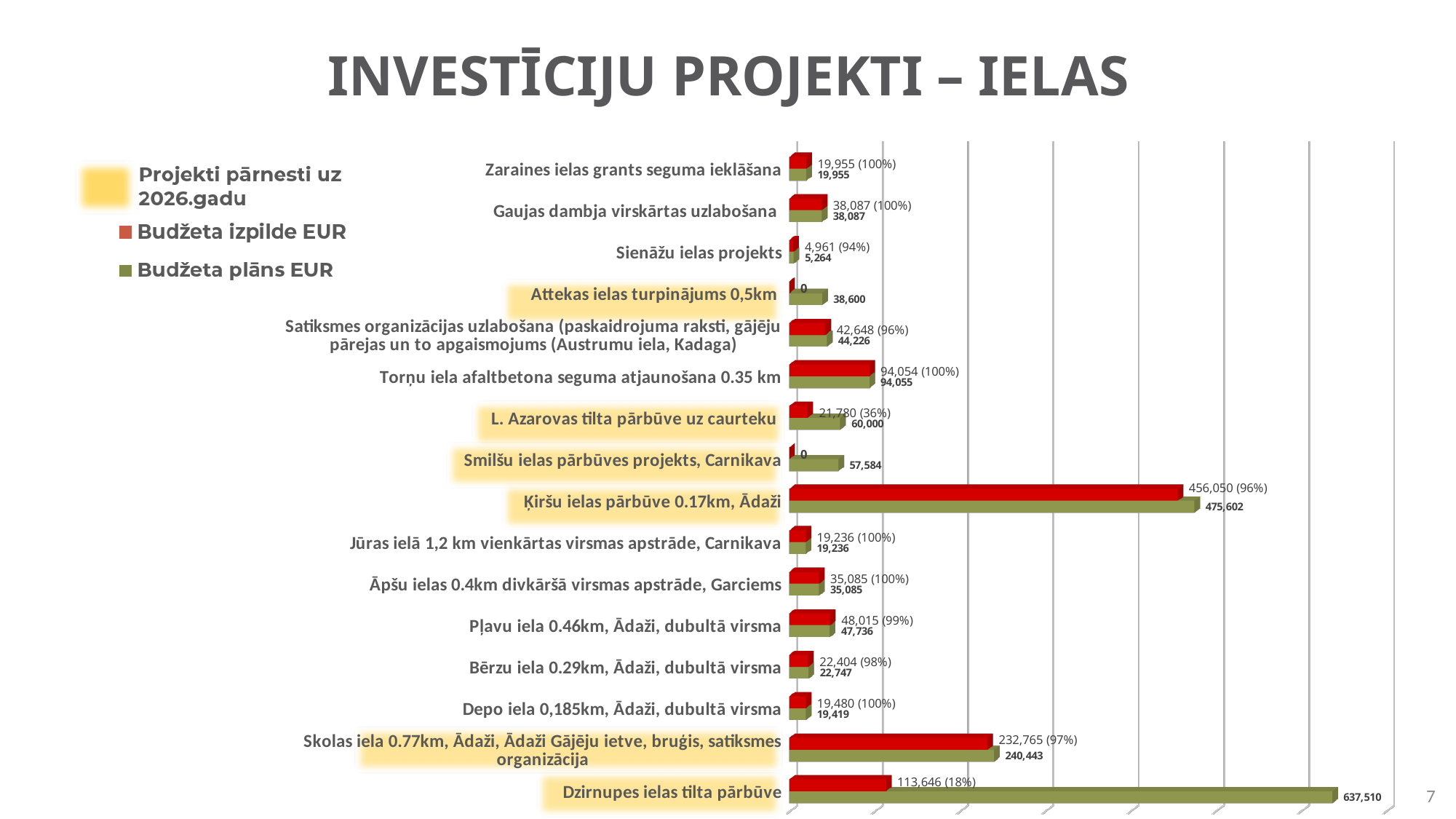
Which project has the highest Budžeta izpilde EUR value? Ķiršu ielas pārbūve 0.17km, Ādaži What is the Budžeta izpilde EUR value for Ķiršu ielas pārbūve 0.17km, Ādaži? 456,050 How many street projects (categories) are plotted in the chart? 16 Which is larger: the Budžeta izpilde EUR value for Skolas iela 0.77km, Ādaži or for Torņu iela afaltbetona seguma atjaunošana 0.35 km? Skolas iela 0.77km, Ādaži How many series does the chart legend list? 2 What is the Budžeta plāns EUR value for Dzirnupes ielas tilta pārbūve? 637,510 Which project has the highest Budžeta plāns EUR value? Dzirnupes ielas tilta pārbūve What type of chart is shown on the slide? bar chart Which project has the lowest Budžeta plāns EUR value? Sienāžu ielas projekts What is the difference between the Budžeta plāns EUR and Budžeta izpilde EUR values for Dzirnupes ielas tilta pārbūve? 523,864 What percentage of the plan is shown next to the Budžeta izpilde EUR value for L. Azarovas tilta pārbūve uz caurteku? 36% What is the Budžeta plāns EUR value for L. Azarovas tilta pārbūve uz caurteku? 60,000